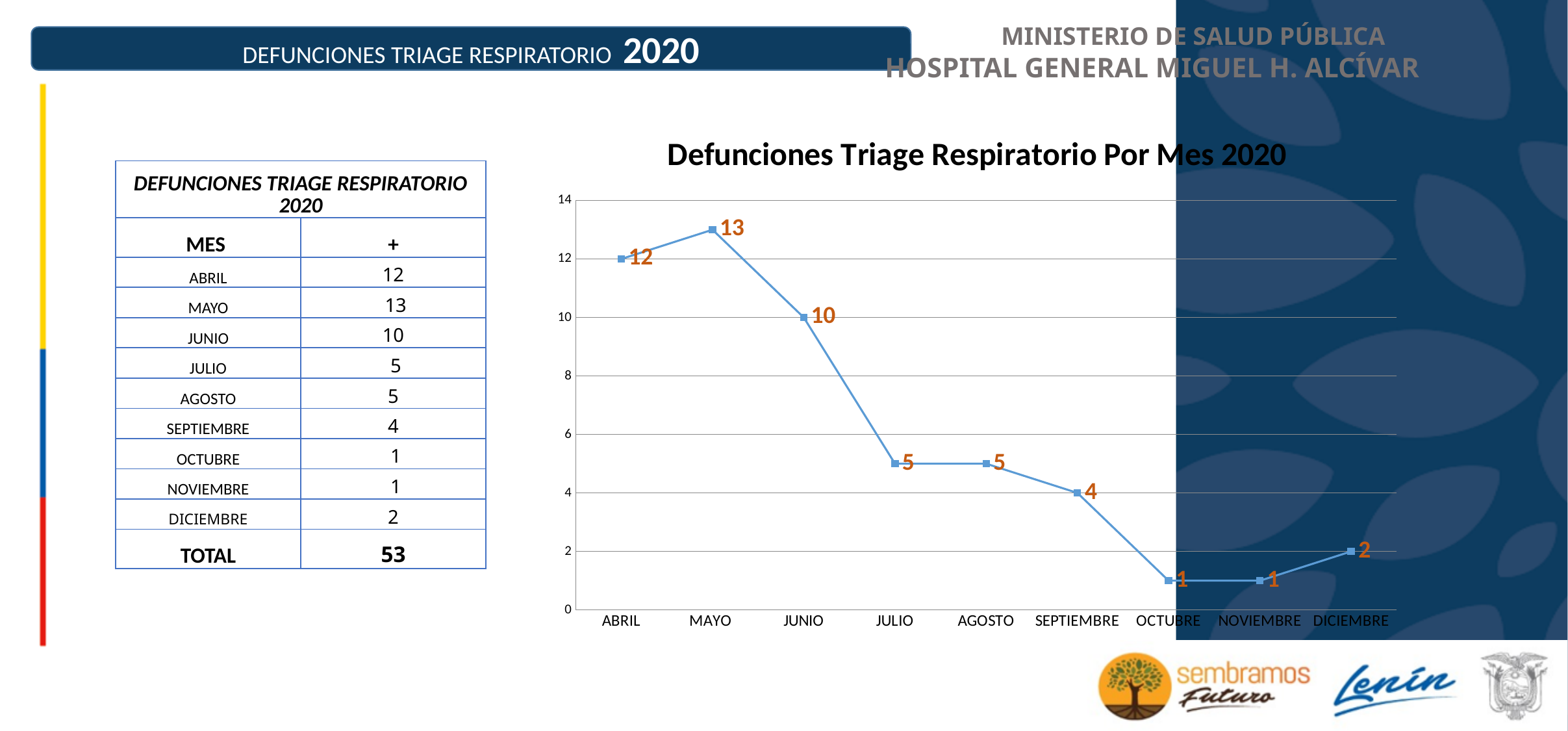
Do the values generally rise or fall from MAYO to OCTUBRE? fall What is the value for SEPTIEMBRE in the chart? 4 How many months are plotted on the x axis of the chart? 9 Which month has the highest value in the chart? MAYO What is the difference between the values for MAYO and JUNIO? 3 Is the value for ABRIL greater or less than 10? greater What is the value for DICIEMBRE in the chart? 2 What is the title of the chart? Defunciones Triage Respiratorio Por Mes 2020 What is the value for MAYO in the chart? 13 What is the difference between the values for ABRIL and DICIEMBRE? 10 Which is larger, the value for JUNIO or the value for JULIO? JUNIO What kind of chart is shown on the slide? line chart